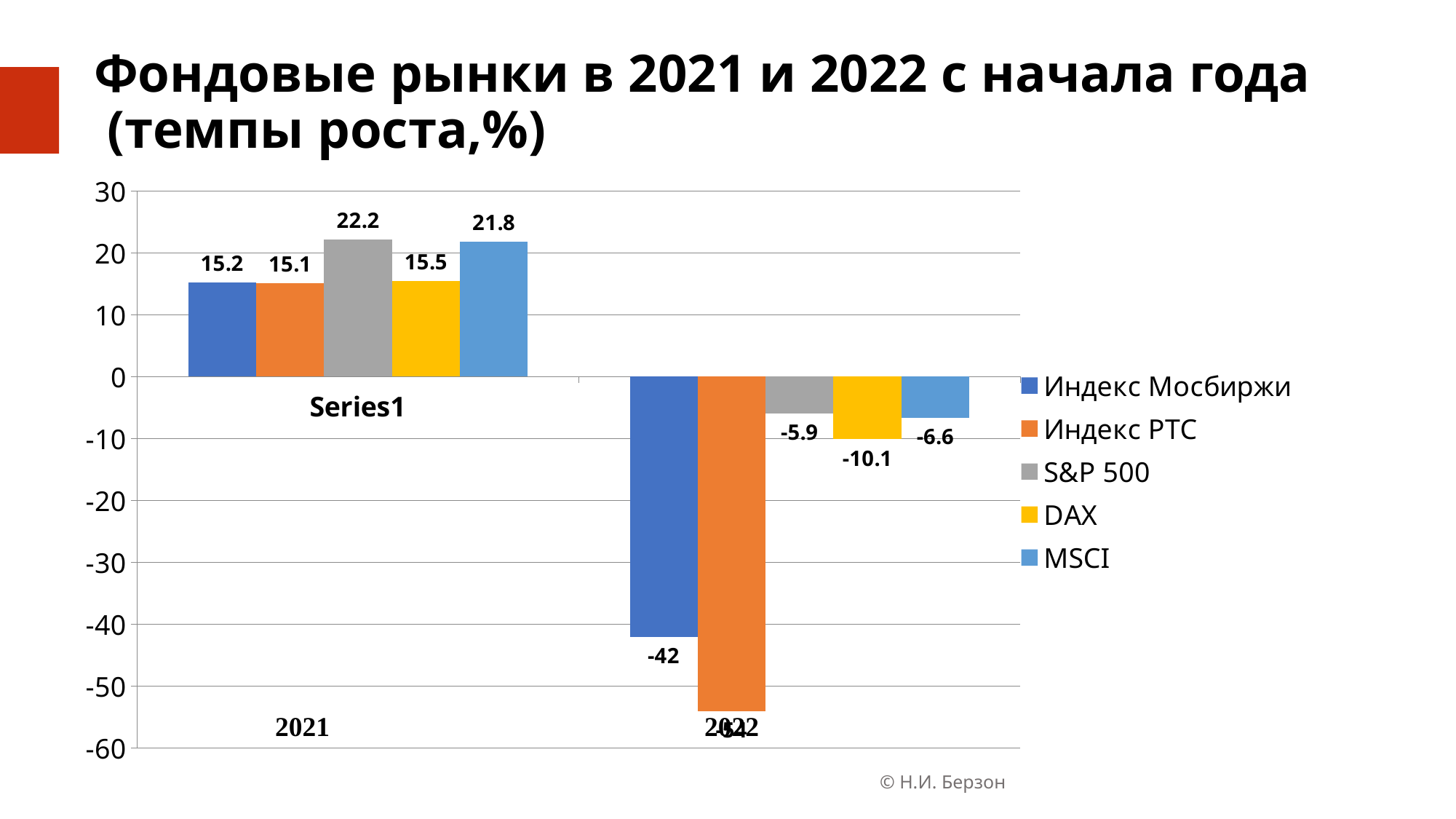
Is the value for Индекс РТС in 2022 greater or less than -50? less How many year categories are shown on the x axis? 2 What is the difference between the S&P 500 and DAX values in 2021? 6.7 In 2022, which is lower: MSCI or S&P 500? MSCI What is the value for MSCI in 2021? 21.8 What is the value for S&P 500 in 2021? 22.2 Which index has the lowest value in 2022? Индекс РТС How many series does the legend list? 5 What kind of chart is shown on the slide? bar chart What is the value for Индекс Мосбиржи in 2022? -42 What is the value for DAX in 2022? -10.1 Which index has the highest value in 2021? S&P 500